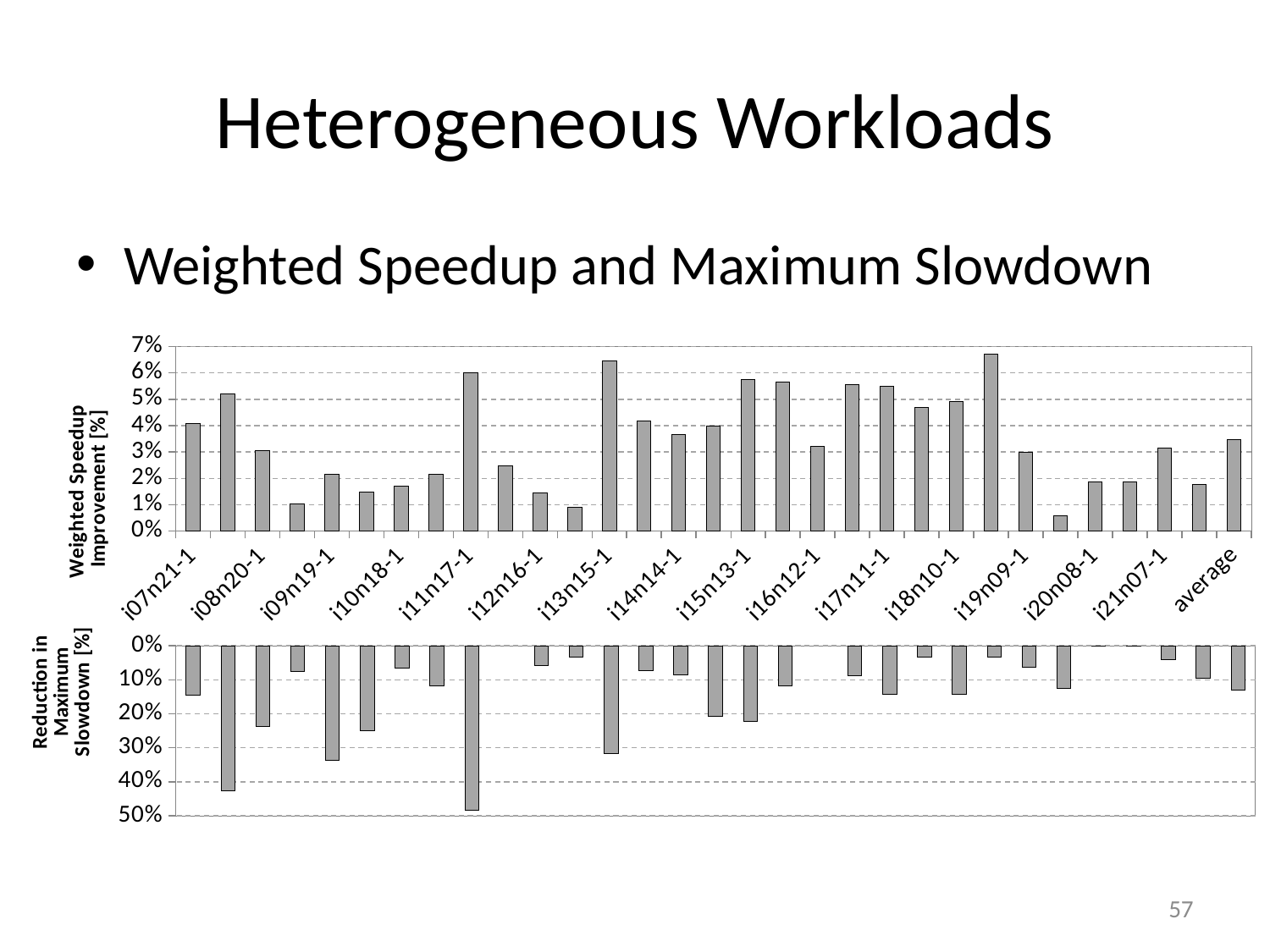
In the top chart (Weighted Speedup Improvement), is the value for i07n21-1 greater or less than 3%? greater In the bottom chart (Reduction in Maximum Slowdown), is the value for i11n17-1 greater or less than 40%? greater What is the y-axis title of the bottom chart? Reduction in Maximum Slowdown [%] In the top chart (Weighted Speedup Improvement), is the value for i20n08-1 greater or less than 1%? greater In the bottom chart (Reduction in Maximum Slowdown), which has the larger reduction, i08n20-1 or i13n15-1? i13n15-1 What kind of chart is the top chart (Weighted Speedup Improvement)? bar chart In the top chart (Weighted Speedup Improvement), which has the larger value, i13n15-1 or i12n16-1? i13n15-1 In the bottom chart (Reduction in Maximum Slowdown), which labeled workload has the largest reduction? i11n17-1